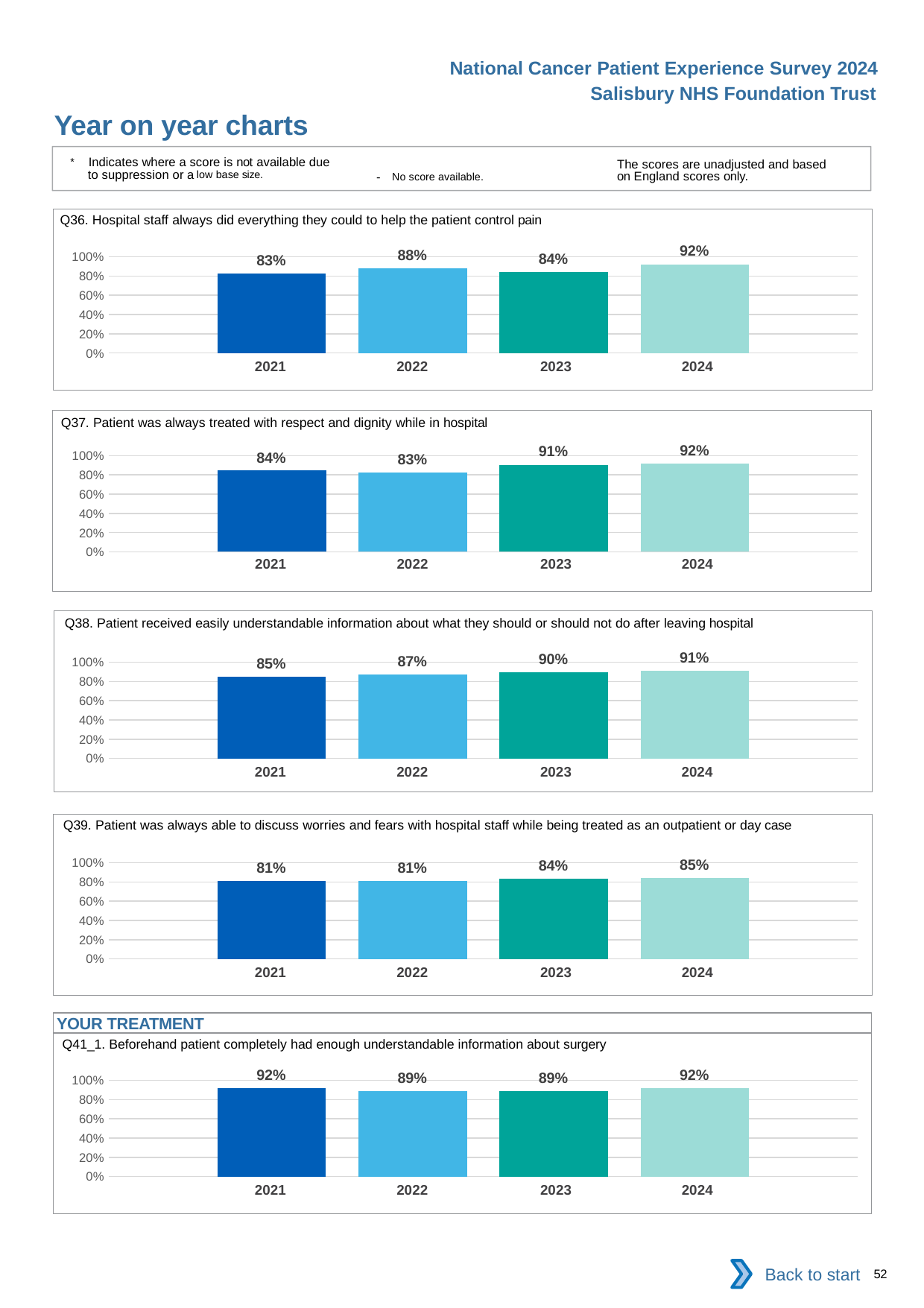
What type of chart is the Q37 chart? bar chart In the Q39 chart, what is the value for 2024? 85% In the Q41_1 chart, what is the difference between the 2021 and 2022 values? 3 percentage points In the Q38 chart, what is the value for 2021? 85% In the Q36 chart, what is the value for 2022? 88% In the Q36 chart, which year has the highest value? 2024 How many years are shown in the Q36 chart? 4 In the Q39 chart, which is larger, the value for 2023 or the value for 2021? 2023 In the Q37 chart, which year has the lowest value? 2022 In the Q41_1 chart, what is the value for 2023? 89% In the Q38 chart, do the values rise or fall from 2021 to 2024? rise In the Q37 chart, what is the difference between the 2024 and 2022 values? 9 percentage points